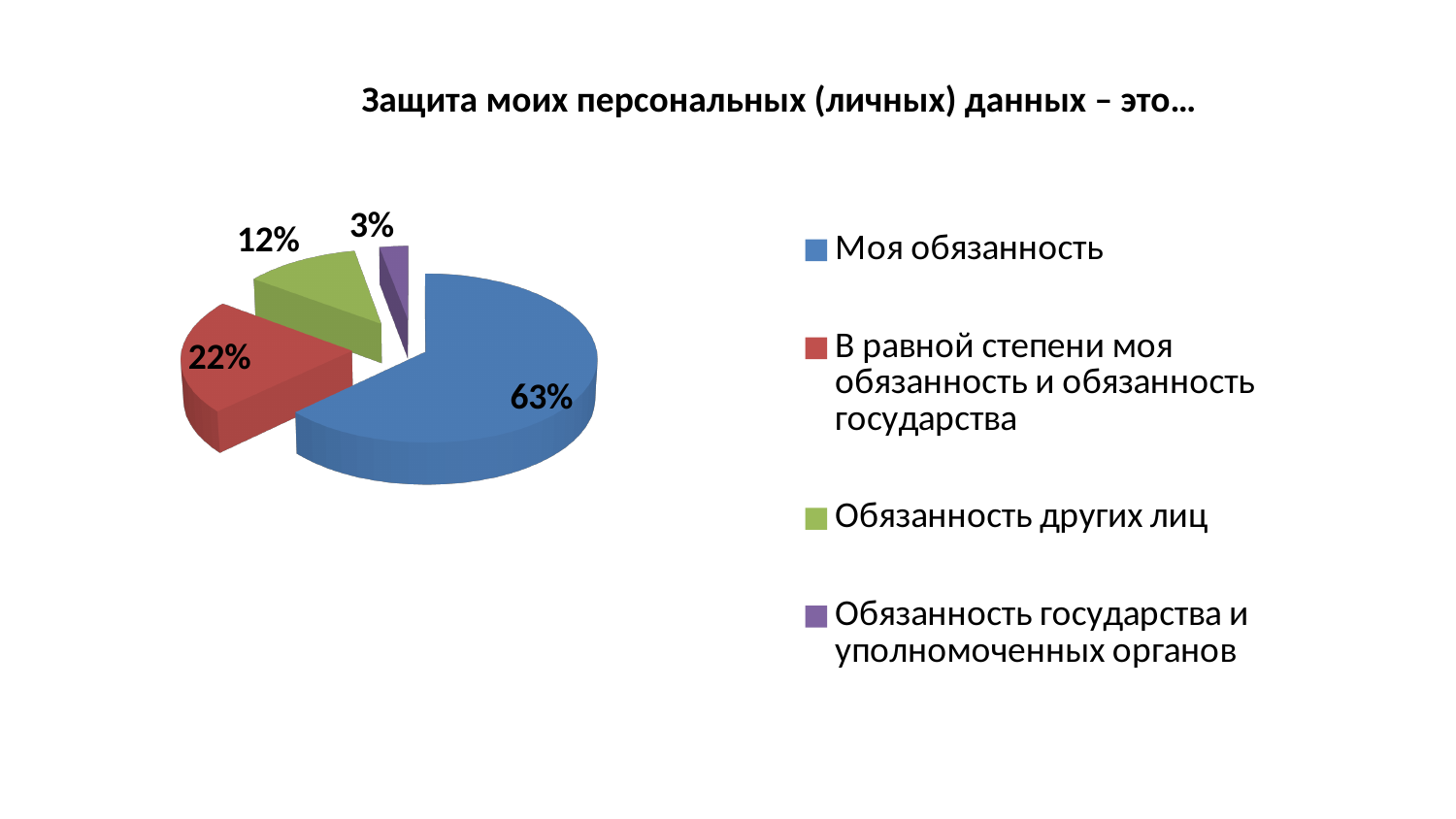
What kind of chart is shown on the slide? pie chart Which category has the smallest slice of the pie? Обязанность государства и уполномоченных органов What colour is the slice for "Обязанность других лиц"? green What share of the pie is labelled "Обязанность других лиц"? 12% What share of the pie is labelled "В равной степени моя обязанность и обязанность государства"? 22% Which category has the largest slice of the pie? Моя обязанность How many slices does the pie chart have? 4 Which is larger: the slice for "Обязанность других лиц" or the slice for "Обязанность государства и уполномоченных органов"? Обязанность других лиц What share of the pie is labelled "Обязанность государства и уполномоченных органов"? 3% What is the difference in percentage points between "Моя обязанность" and "В равной степени моя обязанность и обязанность государства"? 41 What is the title of the chart? Защита моих персональных (личных) данных – это…